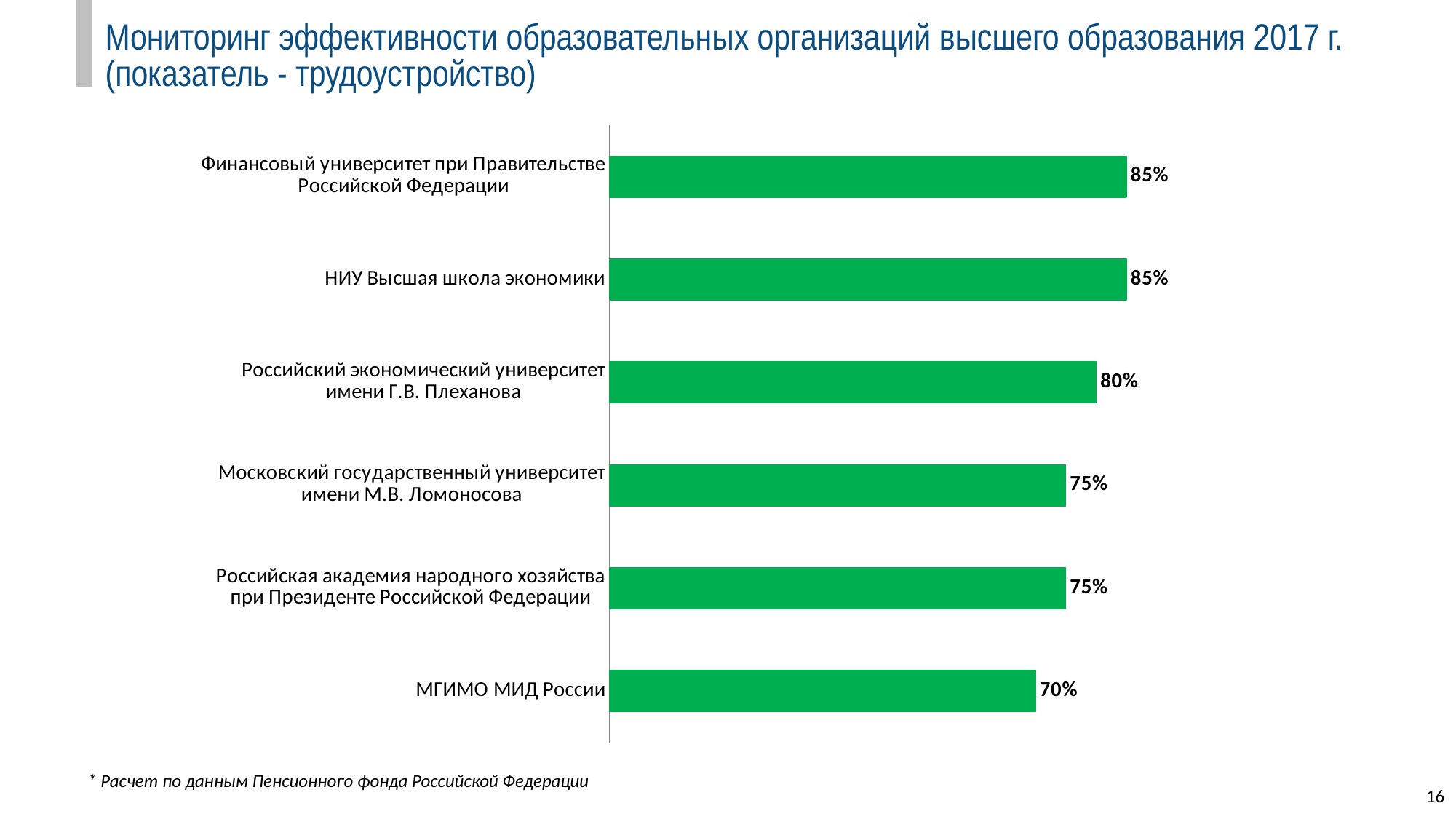
What colour are the bars in the chart? Green What kind of chart is shown on the slide? Bar chart What is the value for Российский экономический университет имени Г.В. Плеханова? 80% Which is larger: the value for МГИМО МИД России or the value for Российский экономический университет имени Г.В. Плеханова? Российский экономический университет имени Г.В. Плеханова What is the difference between the values for Российский экономический университет имени Г.В. Плеханова and Российская академия народного хозяйства при Президенте Российской Федерации? 5% What is the value for Московский государственный университет имени М.В. Ломоносова? 75% How many categories are shown in the chart? 6 What is the value for НИУ Высшая школа экономики? 85% Which is larger: the value for НИУ Высшая школа экономики or the value for Московский государственный университет имени М.В. Ломоносова? НИУ Высшая школа экономики What is the difference between the values for Финансовый университет при Правительстве Российской Федерации and МГИМО МИД России? 15% Which category has the lowest value? МГИМО МИД России What is the value for МГИМО МИД России? 70%